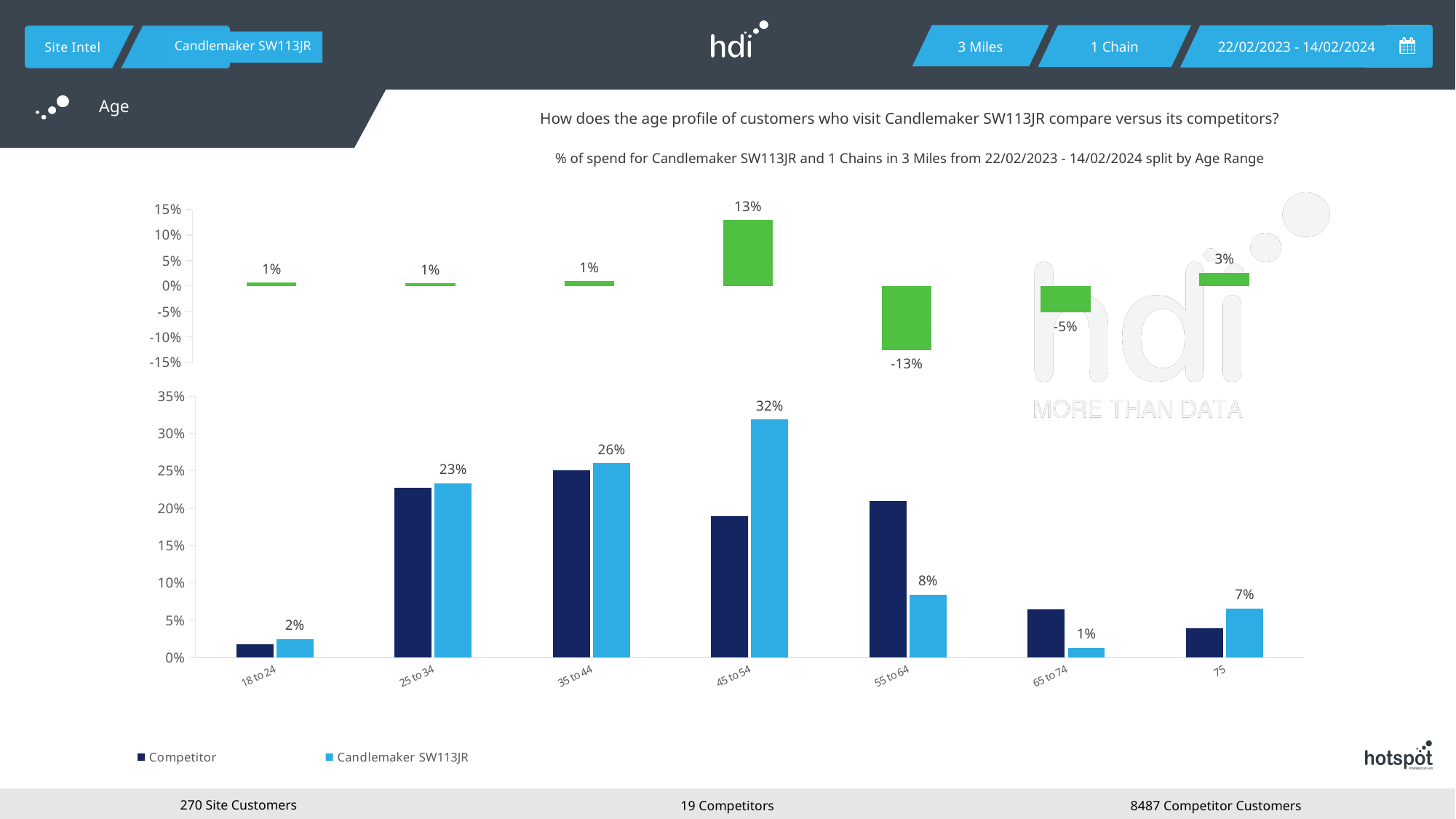
How many series does the legend of the bottom chart list? 2 In the bottom chart, which age range has the highest Candlemaker SW113JR value? 45 to 54 In the bottom chart, what is the Candlemaker SW113JR value for the 65 to 74 age range? 1% In the bottom chart, which age range has the lowest Candlemaker SW113JR value? 65 to 74 In the top chart, what is the value shown for the 75 age range? 3% What type of chart is the bottom chart? Bar chart In the top chart, what is the value shown for the 55 to 64 age range? -13% In the bottom chart, what is the difference between the Candlemaker SW113JR values for 45 to 54 and 55 to 64? 24% In the bottom chart, is the Competitor value for the 45 to 54 age range greater or less than 20%? less How many age ranges are shown on the x axis of the bottom chart? 7 In the bottom chart, for the 55 to 64 age range, which series has the larger value: Competitor or Candlemaker SW113JR? Competitor In the bottom chart, what is the Candlemaker SW113JR value for the 45 to 54 age range? 32%